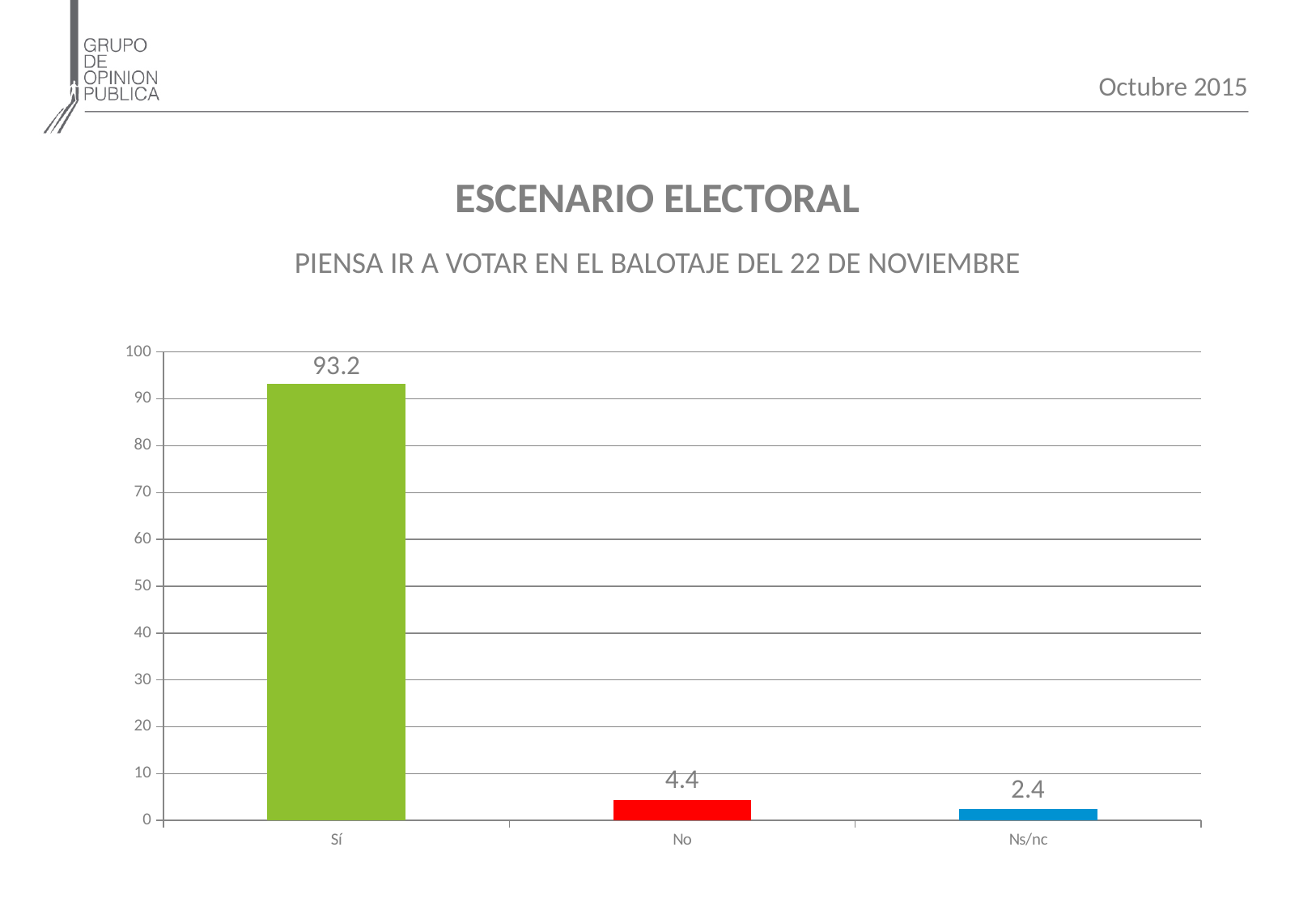
How many categories are shown on the x axis? 3 What is the difference between the values for No and Ns/nc? 2.0 What is the value for No? 4.4 Which category has the lowest value? Ns/nc What is the difference between the values for Sí and No? 88.8 What colour is the bar for Sí? green What is the value for Sí? 93.2 What is the value for Ns/nc? 2.4 Which category has the highest value? Sí Is the value for Sí greater or less than 90? greater What kind of chart is shown on the slide? bar chart Which is larger, the value for No or the value for Ns/nc? No